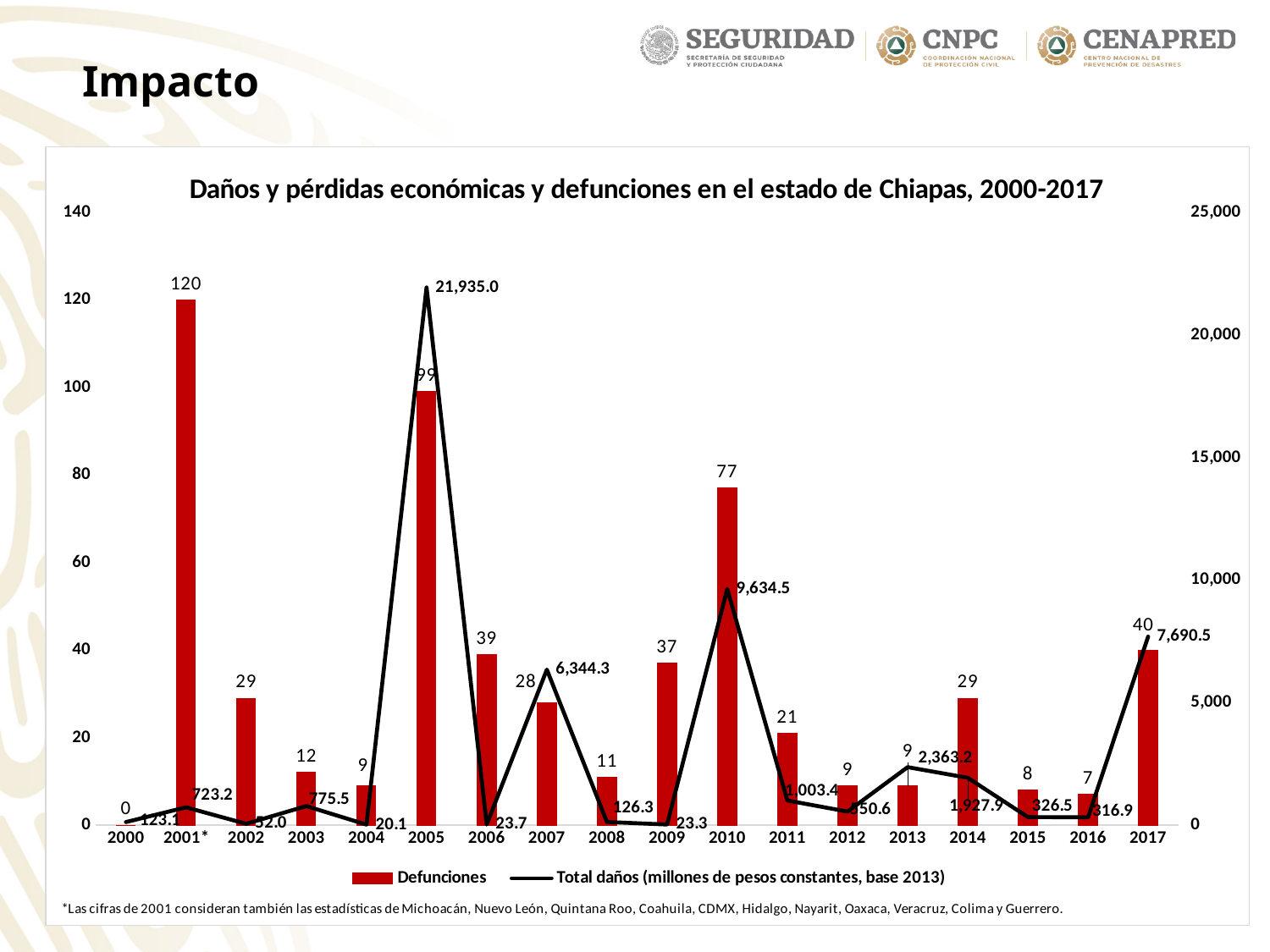
Which year has more Defunciones, 2006 or 2009? 2006 How many deaths (Defunciones) are shown for 2001*? 120 What is the value of Total daños (millones de pesos constantes, base 2013) for 2005? 21,935.0 How many series does the legend list? 2 What is the value of Total daños for 2017? 7,690.5 How many years are shown on the x axis? 18 Which year has the lowest number of Defunciones? 2000 What is the difference in Total daños between 2010 and 2007? 3,290.2 In which year does the Total daños line reach its peak? 2005 Which year has the highest number of Defunciones? 2001* What is the difference in Defunciones between 2010 and 2017? 37 What kind of chart is this? Combined bar and line chart